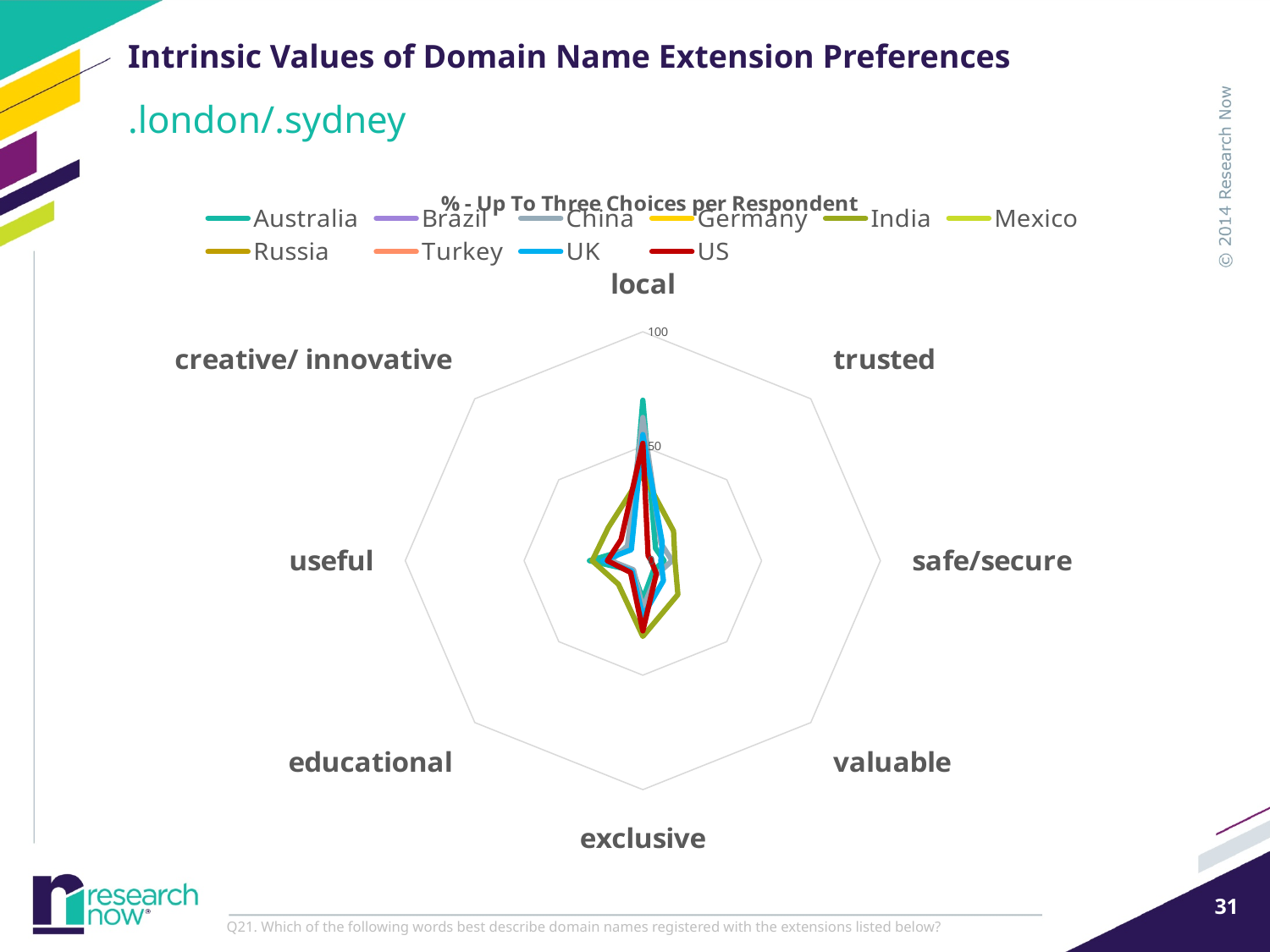
What kind of chart is shown on the slide? radar chart Is the value for UK on the 'safe/secure' axis greater or less than 50? less Is the value for Australia on the 'local' axis greater or less than 50? greater How many series does the legend list? 10 Is the value for India on the 'trusted' axis greater or less than 50? less How many categories (axes) does the radar chart have? 8 On which axis do the series reach their highest values? local Which series has the highest value on the 'local' axis? Australia Which domain extensions does the slide's subtitle refer to? .london/.sydney What is the title of the chart? % - Up To Three Choices per Respondent